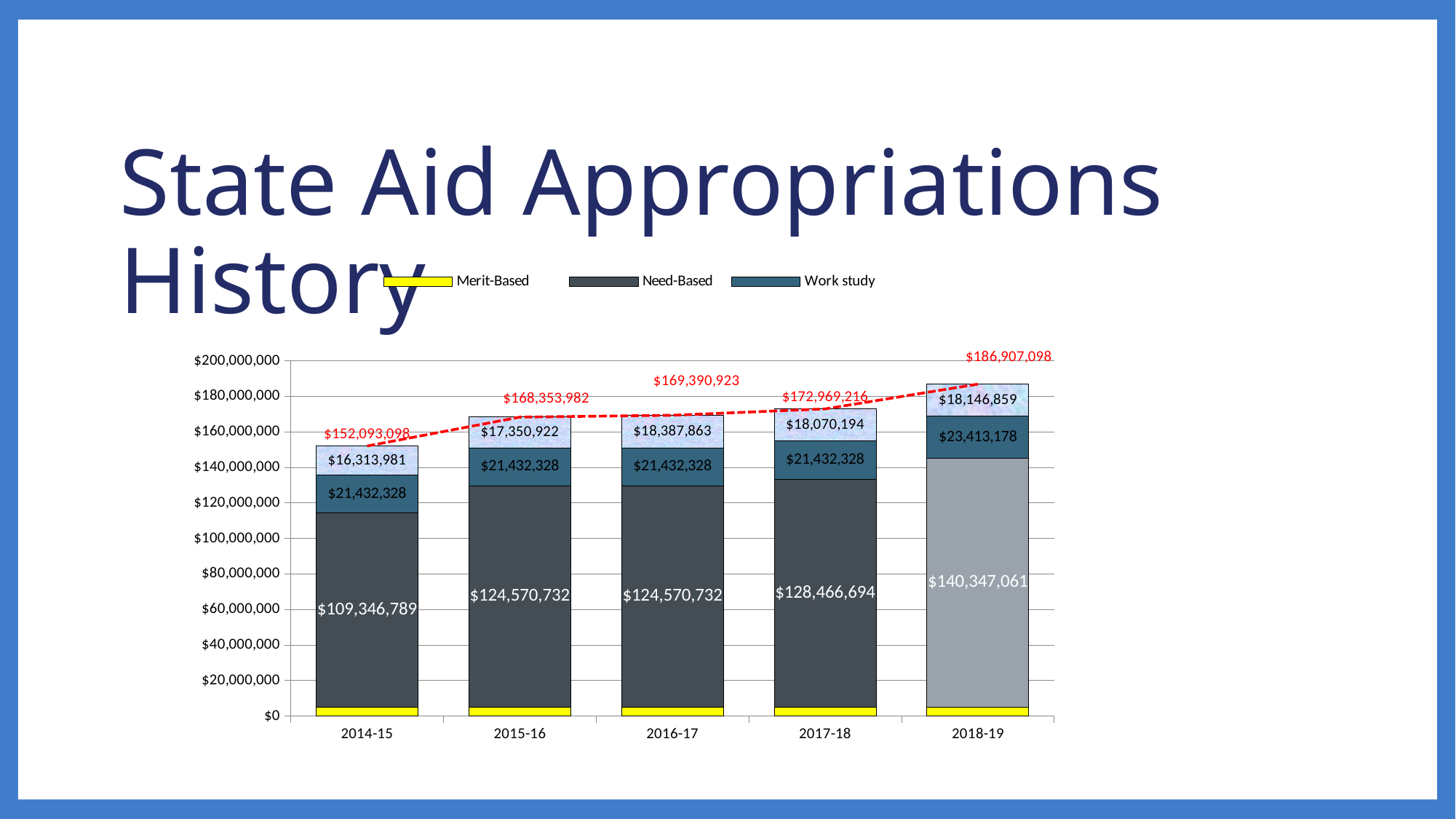
What is the Need-Based value for 2018-19? $140,347,061 How many series does the legend list? 3 What is the difference between the Need-Based values for 2018-19 and 2017-18? $11,880,367 What total is labelled on the red dashed line for 2018-19? $186,907,098 What is the difference between the total for 2018-19 and the total for 2014-15? $34,814,000 What is the Work study value for 2018-19? $23,413,178 Which year has the highest total shown on the red dashed line? 2018-19 What is the Need-Based value for 2014-15? $109,346,789 How many years are shown on the x axis? 5 Is the Merit-Based value for 2014-15 greater or less than $20,000,000? less Which is larger, the Work study value for 2018-19 or for 2017-18? 2018-19 Which year has the lowest total shown on the red dashed line? 2014-15